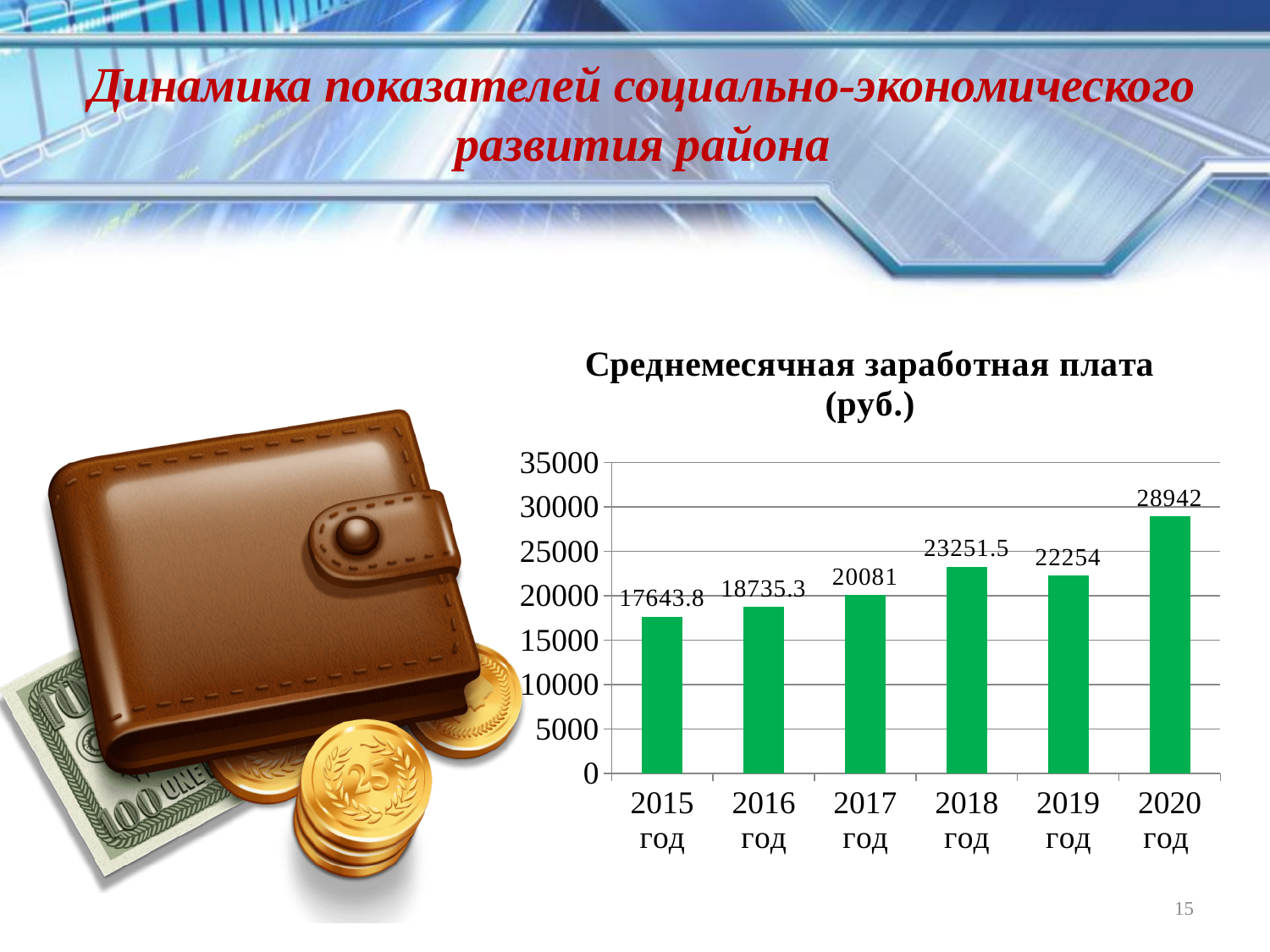
What is the difference between the values for 2020 год and 2019 год? 6688 How many years are shown on the chart? 6 Which year has the highest average monthly salary? 2020 год What is the average monthly salary shown for 2015 год? 17643.8 What is the difference between the values for 2018 год and 2017 год? 3170.5 Which year has the lowest average monthly salary? 2015 год What is the title of the chart? Среднемесячная заработная плата (руб.) What kind of chart is shown on the slide? bar chart What value is shown for 2020 год? 28942 Which is larger, the value for 2018 год or the value for 2019 год? 2018 год Is the value for 2017 год greater or less than 25000? less What value is shown for 2018 год? 23251.5